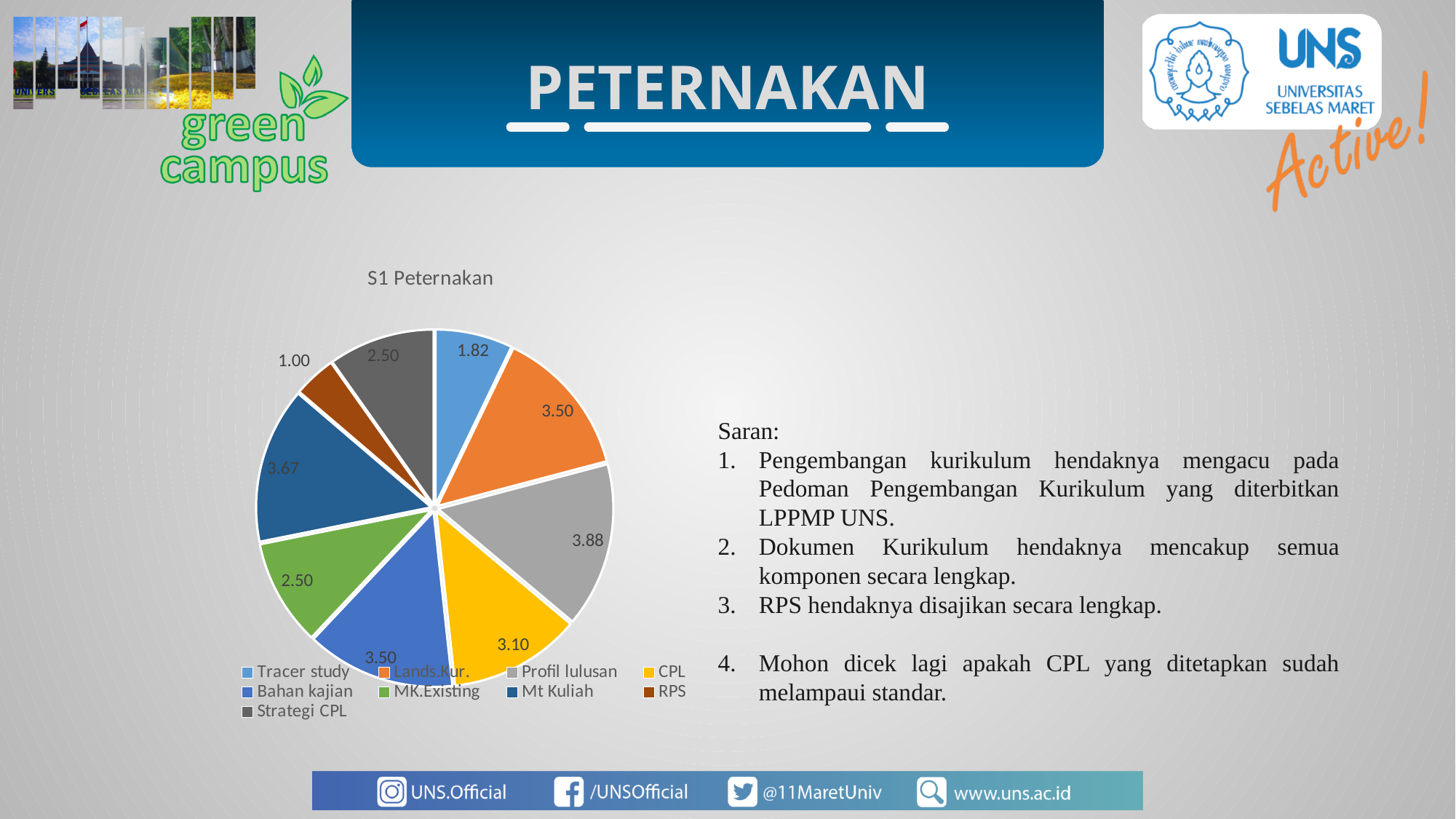
What is the value for CPL? 3.10 What is the value for Tracer study? 1.82 Which colour represents RPS in the legend? Brown Which category has the highest value? Profil lulusan What is the title of the chart? S1 Peternakan Which is larger, the value for Mt Kuliah or the value for Lands.Kur.? Mt Kuliah What type of chart is shown on the slide? Pie chart What is the value for Mt Kuliah? 3.67 What is the difference between the values for Profil lulusan and Tracer study? 2.06 How many categories does the pie chart have? 9 What is the value for Profil lulusan? 3.88 Which category has the lowest value? RPS